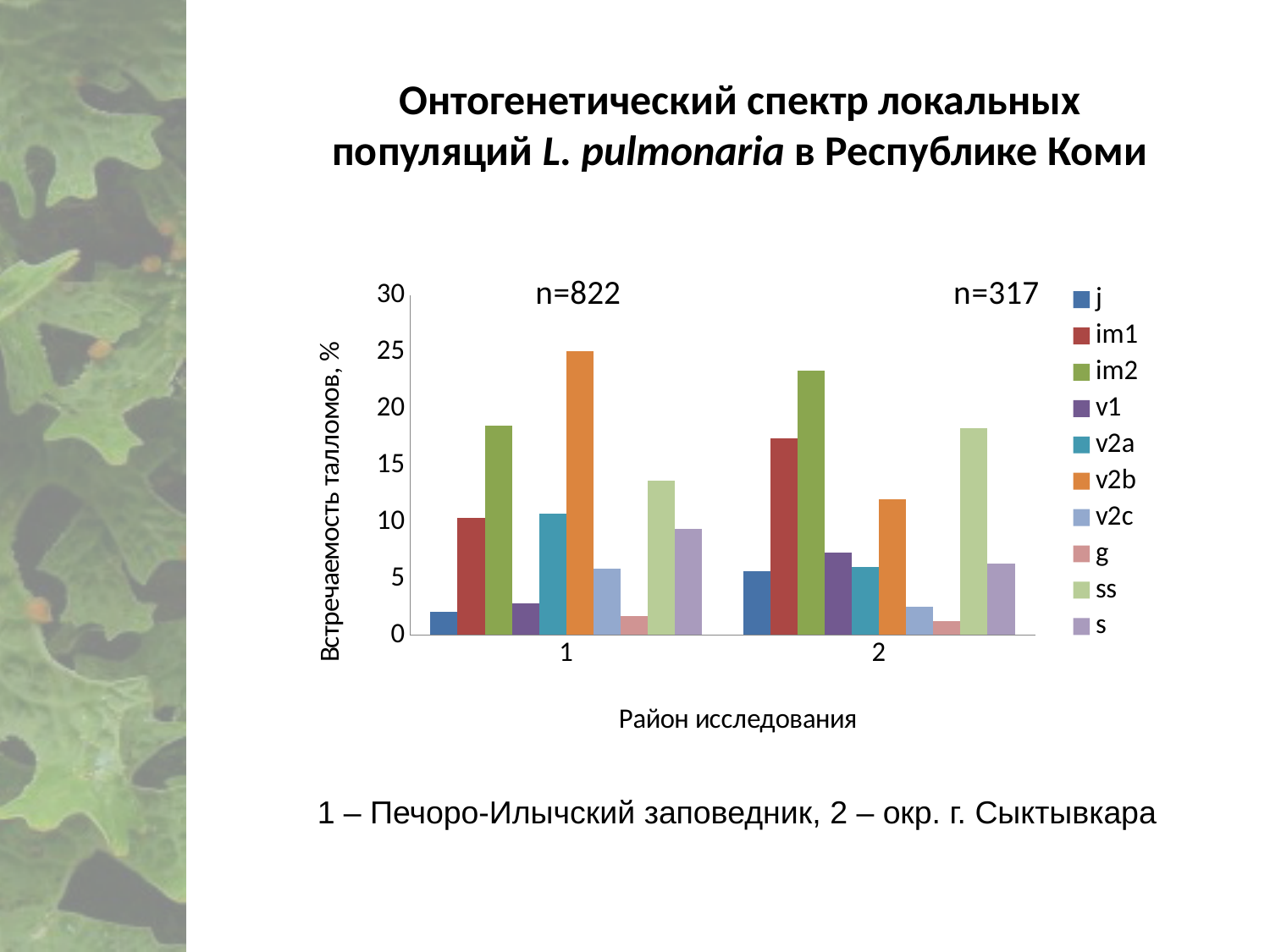
What sample size (n) is shown above district 1? n=822 In district 1, which series has the lowest bar? g In district 2, which series has the lowest bar? g Which district has the larger value for im1, district 1 or district 2? district 2 How many categories (study districts) are shown on the x axis? 2 In district 1, which series has the highest bar? v2b Which district has the larger value for v2b, district 1 or district 2? district 1 How many series does the legend list? 10 In district 2, which series has the highest bar? im2 Is the value for v2b in district 1 greater or less than 20? greater What kind of chart is shown on the slide? bar chart Is the value for im2 in district 2 greater or less than 20? greater